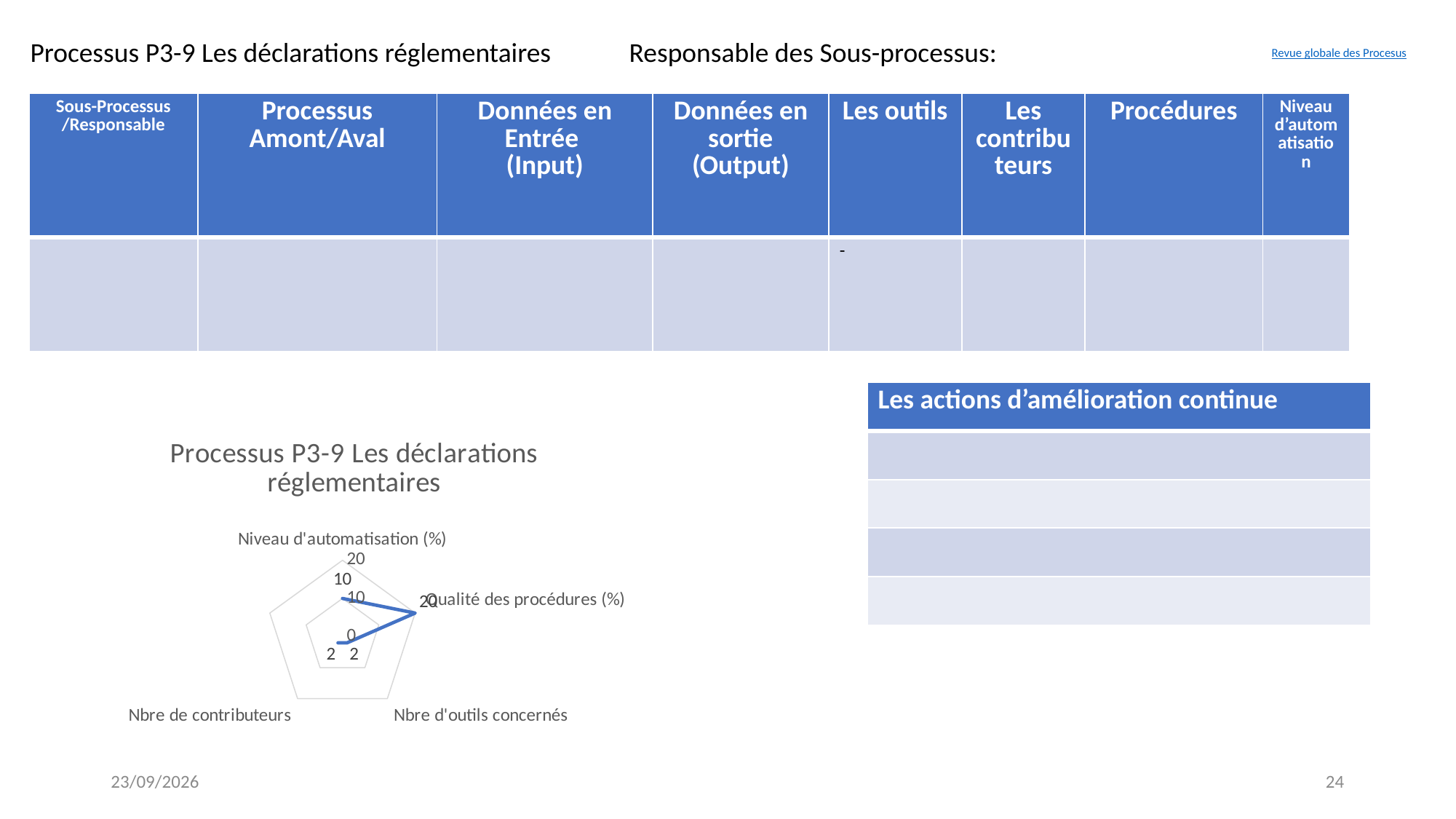
What kind of chart is shown on the slide? radar chart What is the value for Nbre d'outils concernés in the radar chart? 2 What is the value for Nbre de contributeurs in the radar chart? 2 Which labelled axis has the highest value in the radar chart? Qualité des procédures (%) What is the difference between the values for Qualité des procédures (%) and Niveau d'automatisation (%)? 10 Which is larger in the radar chart: the value for Qualité des procédures (%) or the value for Niveau d'automatisation (%)? Qualité des procédures (%) Is the value for Nbre d'outils concernés greater or less than 10? less What is the title of the chart on the slide? Processus P3-9 Les déclarations réglementaires What is the highest tick value shown on the radar chart's axis scale? 20 How many axes does the radar chart have? 5 What is the value for Niveau d'automatisation (%) in the radar chart? 10 What is the value for Qualité des procédures (%) in the radar chart? 20